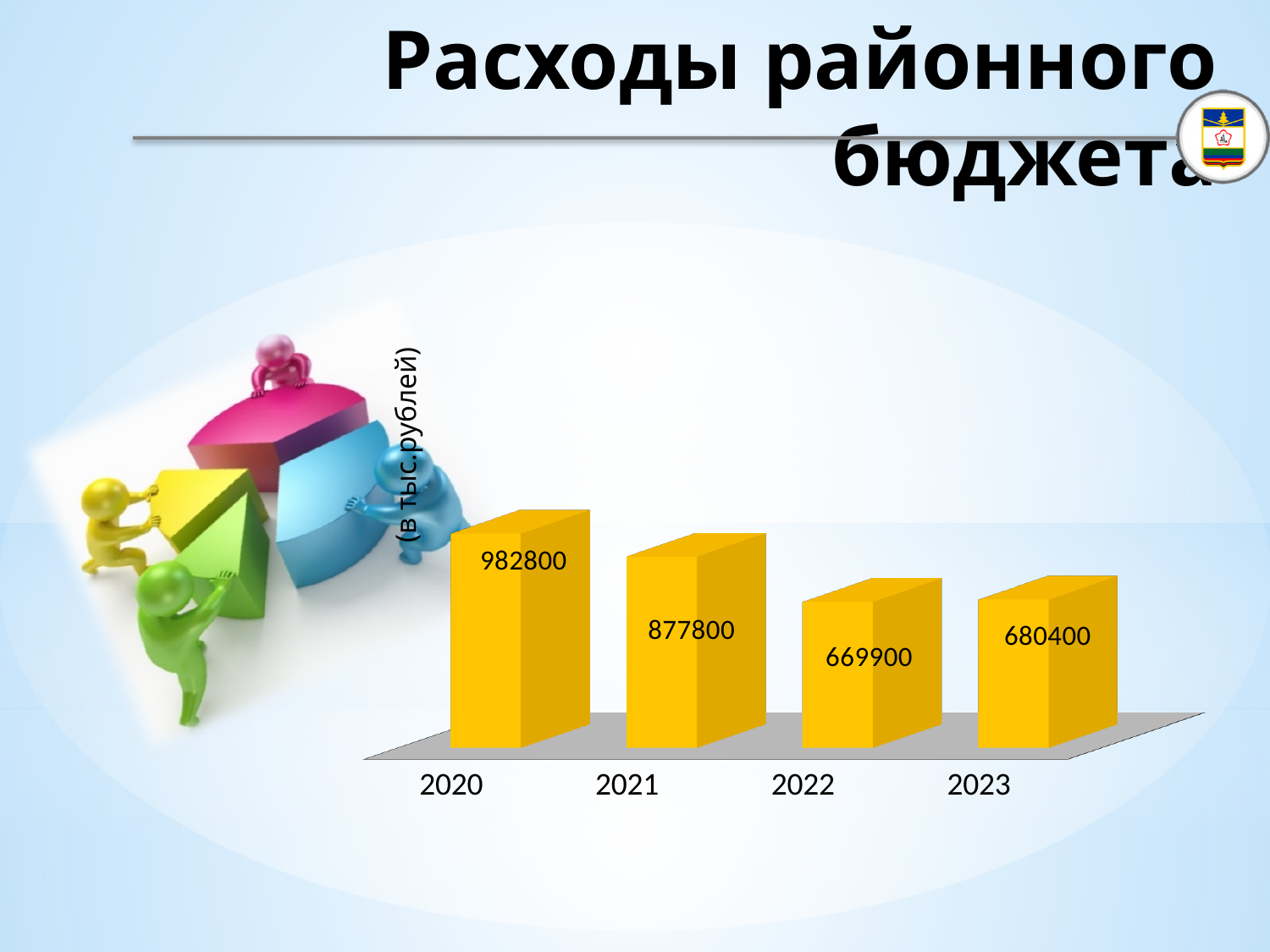
What is the value for 2022? 669900 What is the difference between the values for 2023 and 2022? 10500 What is the difference between the values for 2020 and 2021? 105000 Which year has the highest value? 2020 How many years are shown on the chart? 4 What kind of chart is shown on the slide? bar chart Which is larger, the value for 2022 or the value for 2023? 2023 What is the value for 2020? 982800 What is the value for 2021? 877800 What unit is given on the vertical axis label of the chart? тыс.рублей Which year has the lowest value? 2022 What is the value for 2023? 680400